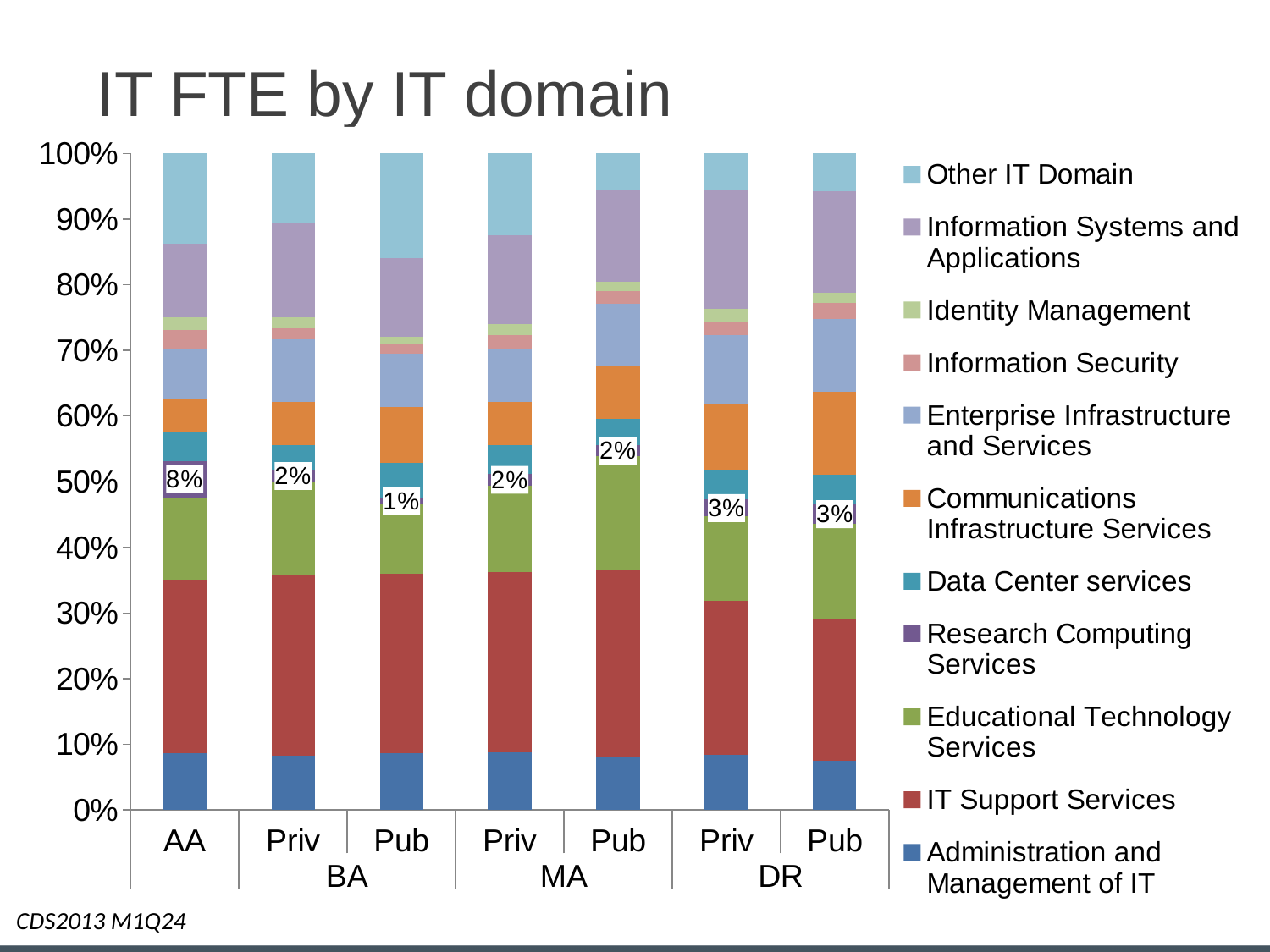
What is the labelled value for Research Computing Services in the DR Priv bar? 3% What is the labelled value for Research Computing Services in the AA bar? 8% What kind of chart is shown on the slide? Stacked bar chart Which bar has the highest labelled Research Computing Services share? AA Which has a larger Research Computing Services share, AA or DR Pub? AA How many series does the legend list? 11 What is the difference between the Research Computing Services share for AA and for BA Pub? 7% Which bar has the lowest labelled Research Computing Services share? BA Pub Is the Administration and Management of IT segment in the AA bar greater or less than 10%? less What is the labelled value for Research Computing Services in the BA Pub bar? 1% How many bars are plotted in the chart? 7 What is the title of the chart? IT FTE by IT domain